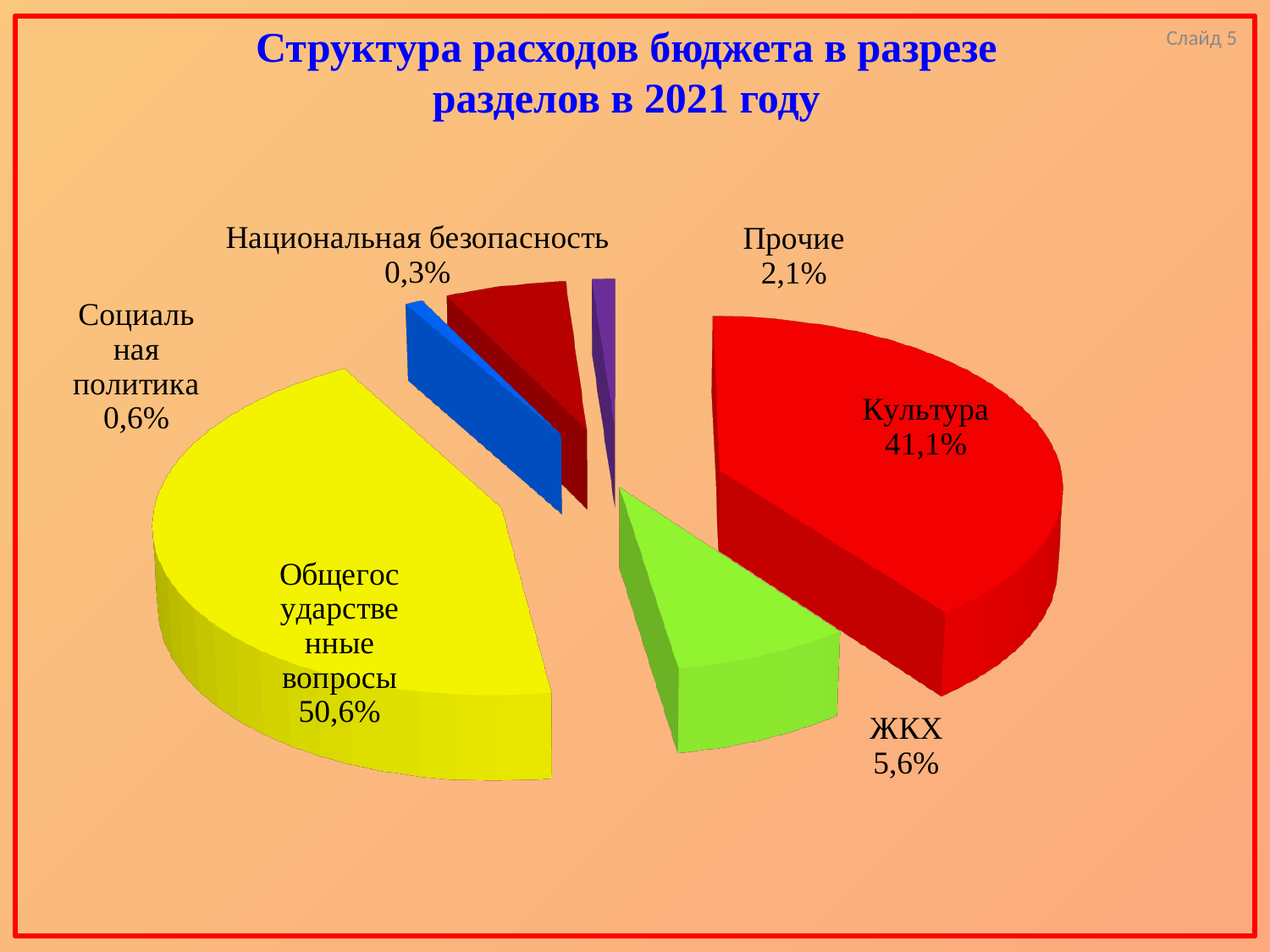
What type of chart is shown on the slide? Pie chart What share is labelled for Социальная политика? 0,6% What share of the pie does Общегосударственные вопросы have? 50,6% Which section has the smallest share of the pie? Национальная безопасность What is the value shown for Культура? 41,1% How many sections are shown in the pie chart? 6 What is the value for Национальная безопасность? 0,3% What colour is the slice for Культура? Red What percentage is shown for ЖКХ? 5,6% What is the difference in percentage points between Общегосударственные вопросы and Культура? 9,5 Which is larger, the share for ЖКХ or the share for Прочие? ЖКХ Which section has the largest share of the pie? Общегосударственные вопросы